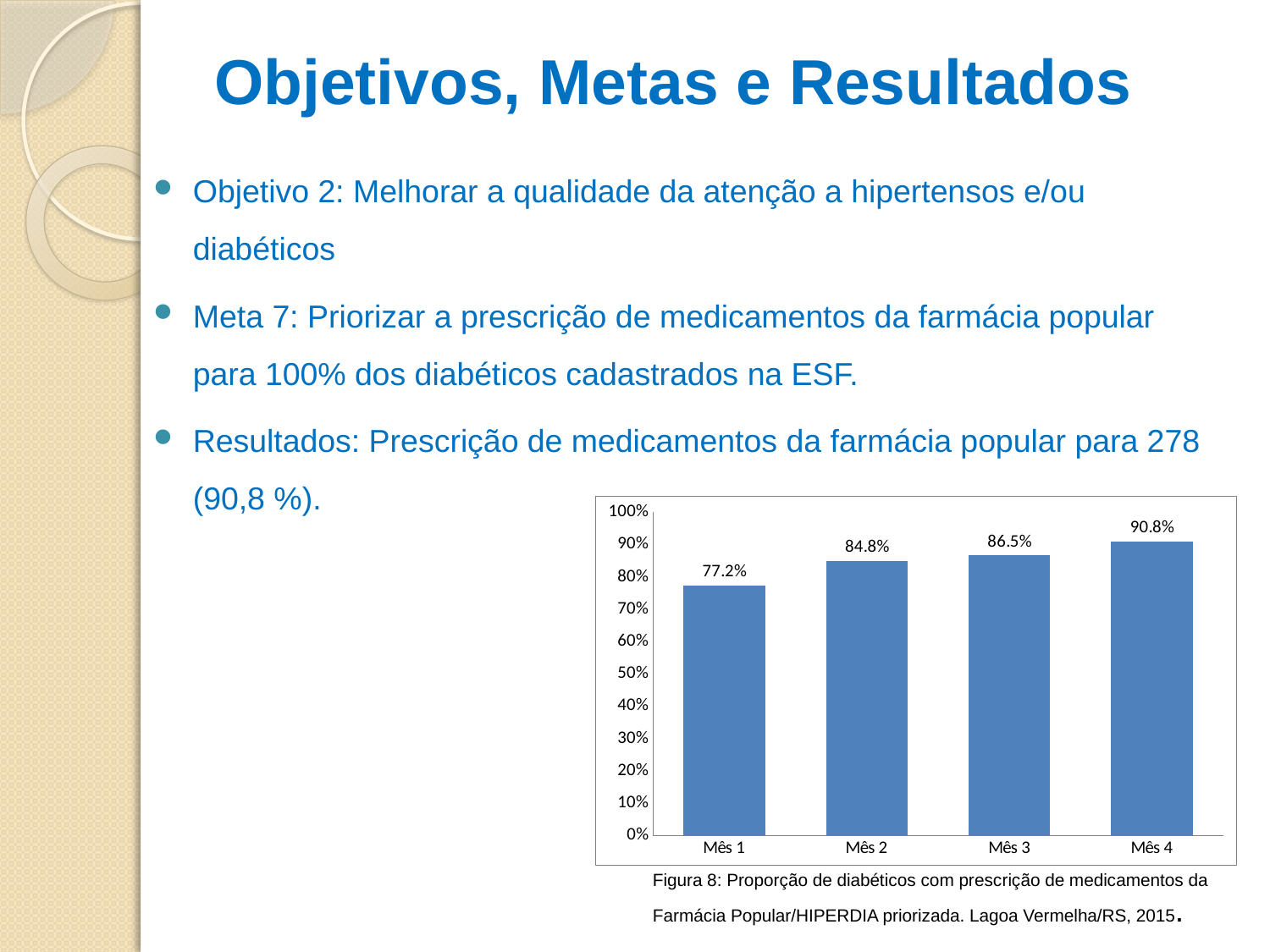
What is the value for Mês 1? 77.2% Do the values rise or fall from Mês 1 to Mês 4? rise What is the difference between the values for Mês 3 and Mês 2? 1.7% Which month has the lowest value? Mês 1 Which is larger, the value for Mês 2 or the value for Mês 3? Mês 3 What is the difference between the values for Mês 4 and Mês 1? 13.6% Is the value for Mês 1 greater or less than 80%? less Which month has the highest value? Mês 4 What is the value for Mês 2? 84.8% How many months are shown on the x axis? 4 What is the value for Mês 4? 90.8% What kind of chart is shown on the slide? bar chart